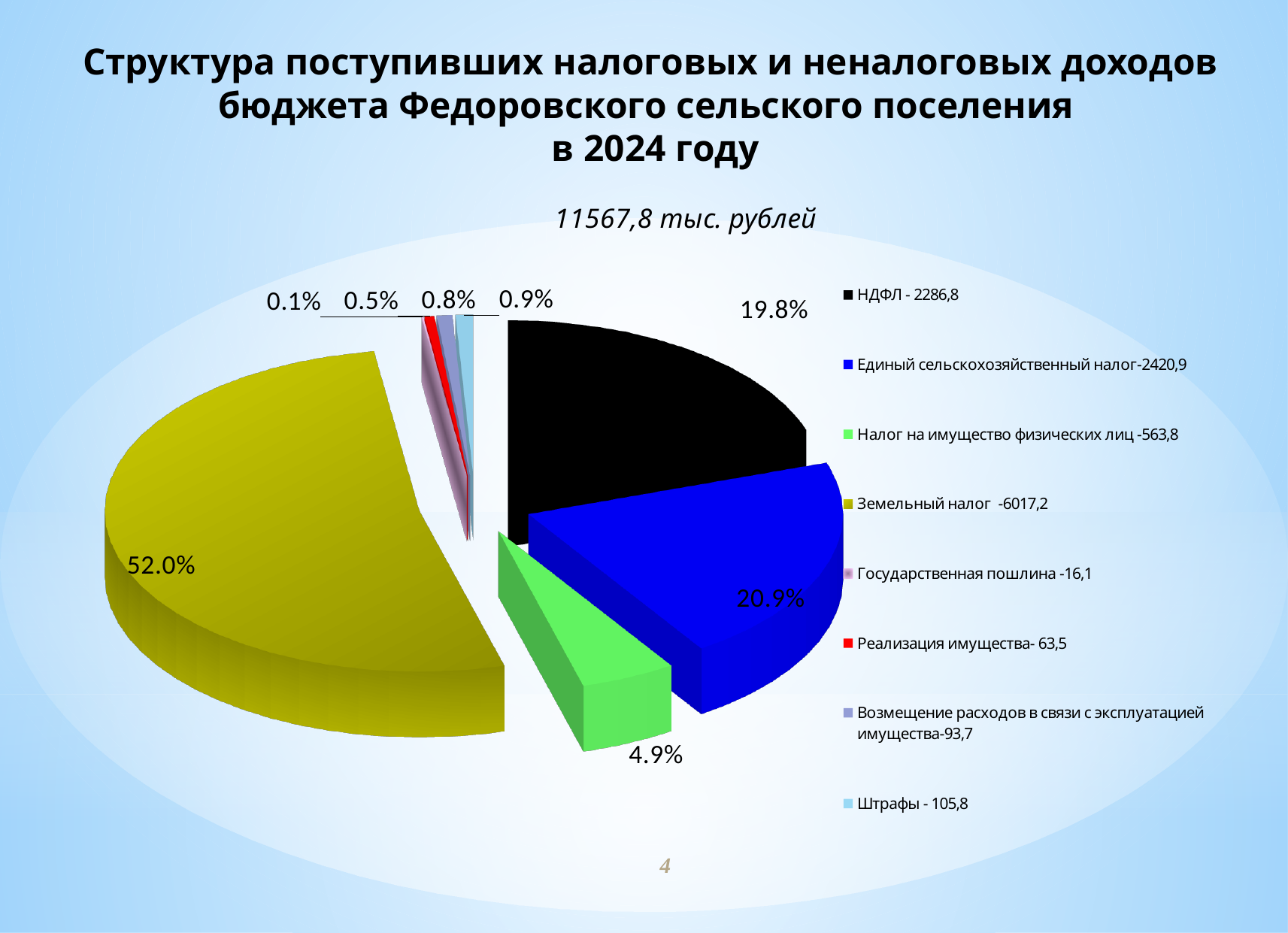
What share of the pie does Налог на имущество физических лиц represent? 4.9% Which is larger, the share for Единый сельскохозяйственный налог or the share for НДФЛ? Единый сельскохозяйственный налог What share of the pie does Земельный налог represent? 52.0% What kind of chart is shown on the slide? pie chart What value is shown in the legend for Штрафы? 105,8 How many slices does the pie chart have? 8 What value is shown in the legend for Реализация имущества? 63,5 What share of the pie does НДФЛ represent? 19.8% Which category has the largest slice of the pie? Земельный налог What total amount is stated above the pie chart? 11567,8 тыс. рублей Which category has the smallest slice of the pie? Государственная пошлина